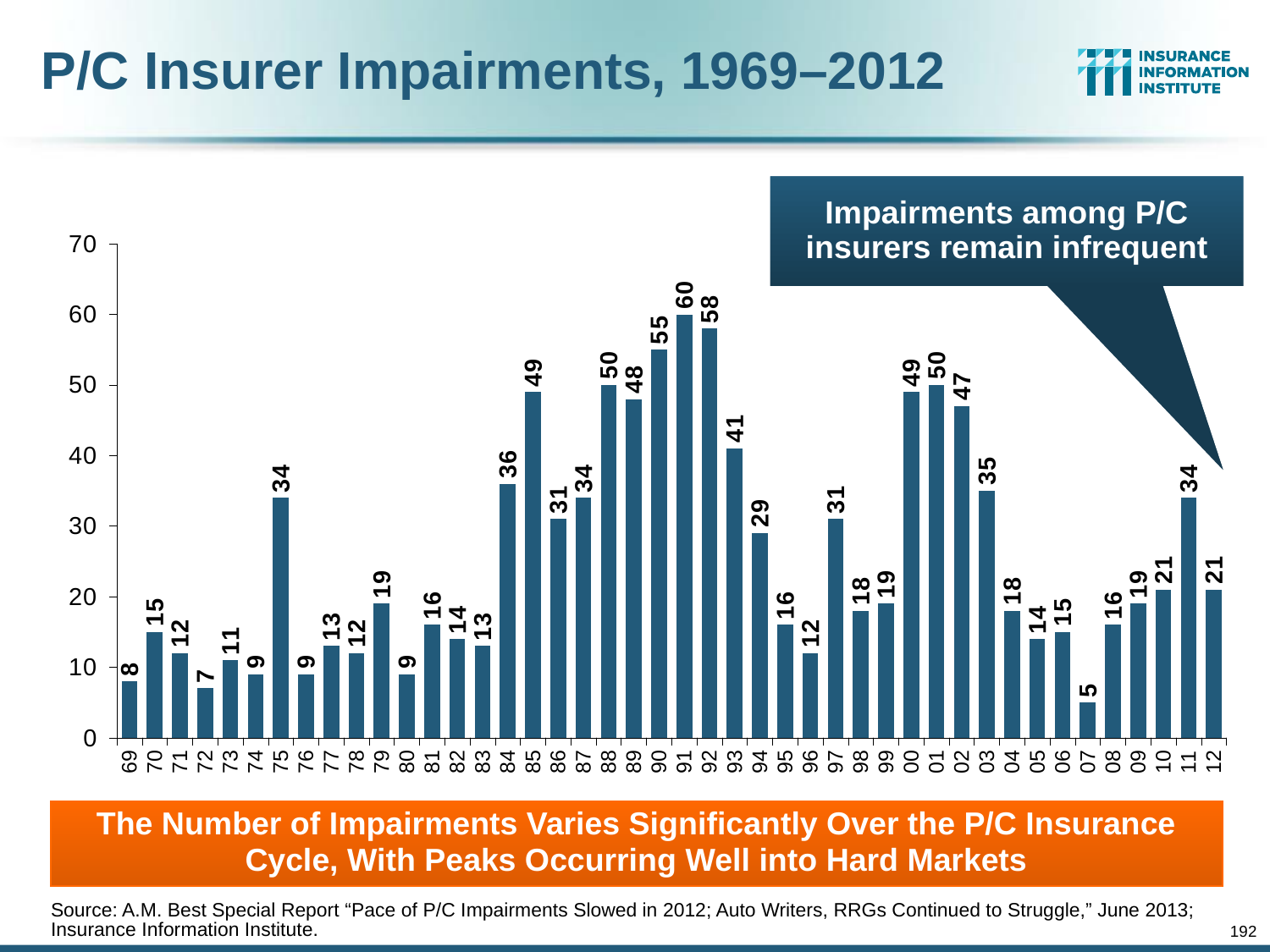
Which year had more impairments, 1985 or 2002? 1985 How many years (bars) are plotted in the chart? 44 How many impairments are shown for 1975? 34 What is the difference between the impairments in 1991 and 1992? 2 Did the number of impairments rise or fall from 2008 to 2011? Rise How many P/C insurer impairments were there in 1991? 60 How many more impairments were there in 2001 than in 2012? 29 What type of chart is shown on the slide? Bar chart Which year had more impairments, 1994 or 1997? 1997 Which year has the highest number of impairments? 1991 What is the value shown for 2007? 5 Which year has the lowest number of impairments? 2007